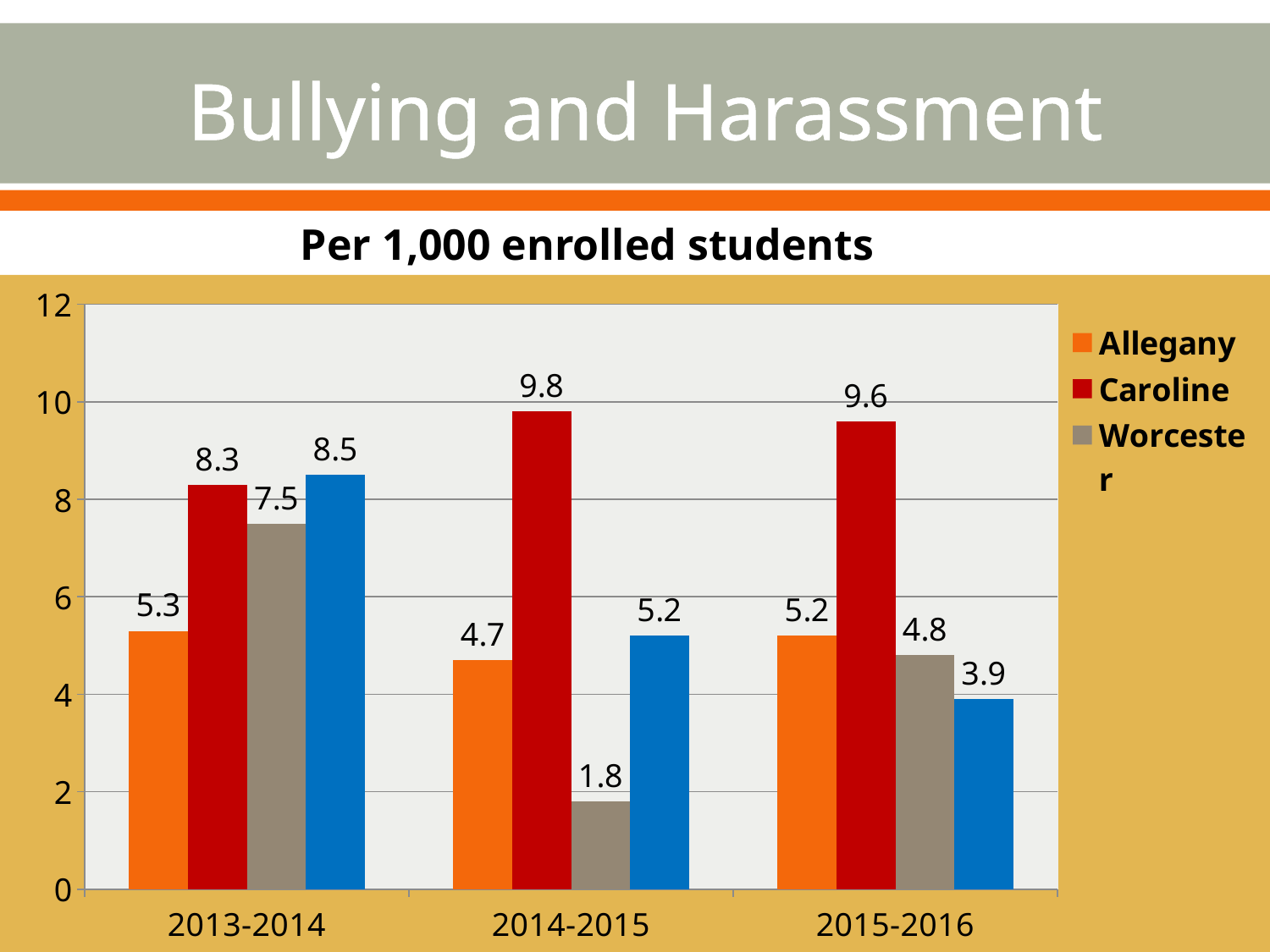
What is the difference between the Worcester values in 2013-2014 and 2014-2015? 5.7 What is the value for Caroline in 2014-2015? 9.8 In which school year is the Worcester value lowest? 2014-2015 What is the value for Worcester in 2015-2016? 4.8 How many series does the legend list? 3 How many school years are shown on the x axis? 3 Is the value for Caroline in 2015-2016 greater or less than 8? greater What is the value for Allegany in 2013-2014? 5.3 In which school year is the Caroline value highest? 2014-2015 What is the difference between the Caroline and Allegany values in 2015-2016? 4.4 What kind of chart is shown on the slide? bar chart Which is larger in 2013-2014, the Caroline value or the Worcester value? Caroline